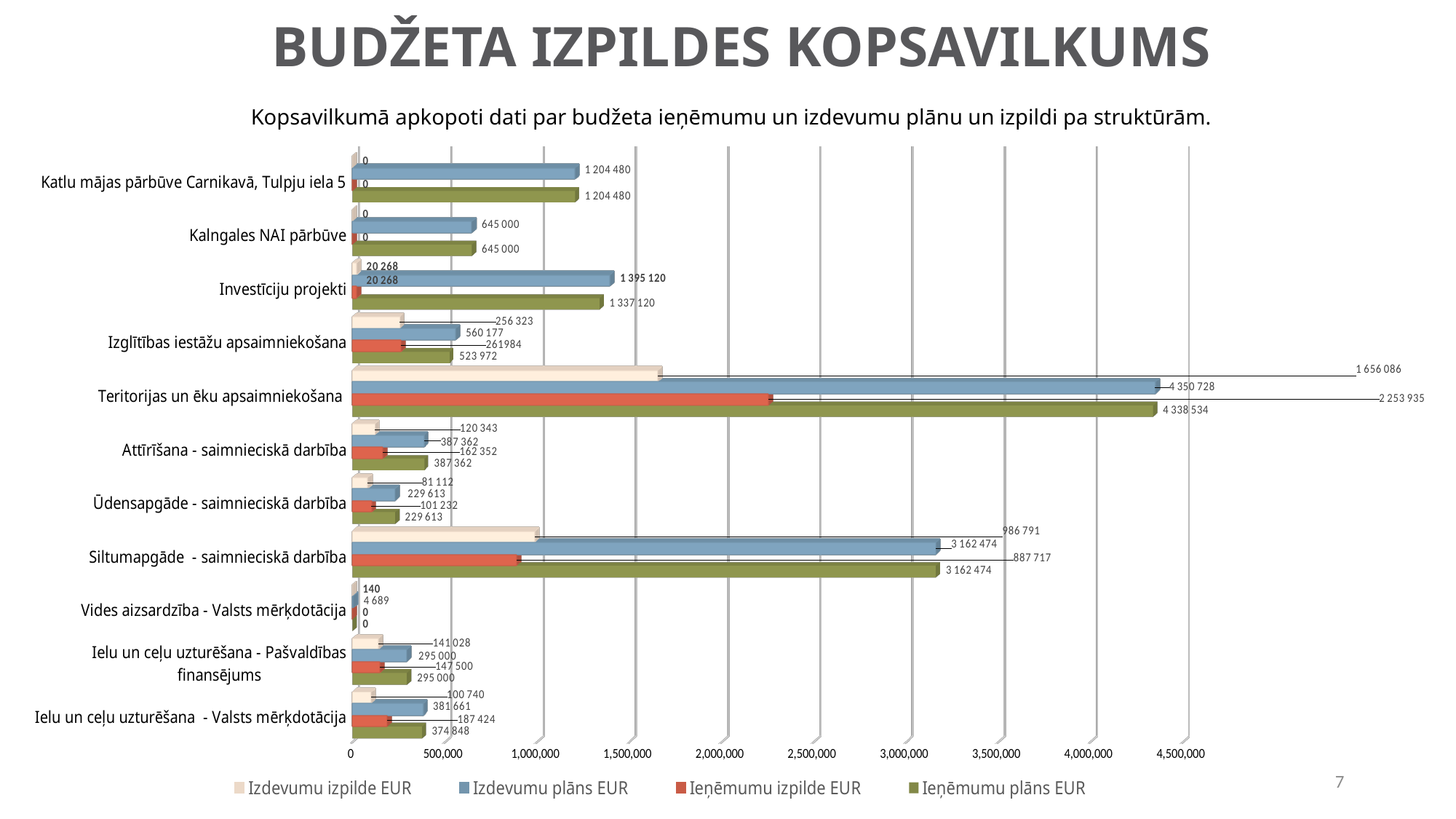
Is the Izdevumu izpilde EUR value for Teritorijas un ēku apsaimniekošana greater or less than 1,500,000? greater What is the Izdevumu plāns EUR value for Teritorijas un ēku apsaimniekošana? 4 350 728 For Ielu un ceļu uzturēšana - Valsts mērķdotācija, which is larger: Ieņēmumu izpilde EUR or Izdevumu izpilde EUR? Ieņēmumu izpilde EUR What is the Izdevumu izpilde EUR value for Izglītības iestāžu apsaimniekošana? 256 323 Which colour represents Ieņēmumu plāns EUR in the legend? green How many series does the legend list? 4 What is the difference between Izdevumu plāns EUR and Izdevumu izpilde EUR for Siltumapgāde - saimnieciskā darbība? 2 175 683 How many categories are shown on the chart? 11 What kind of chart is shown on the slide? bar chart What is the Ieņēmumu izpilde EUR value for Siltumapgāde - saimnieciskā darbība? 887 717 Which category has the lowest Izdevumu plāns EUR value? Vides aizsardzība - Valsts mērķdotācija Which category has the highest Ieņēmumu plāns EUR value? Teritorijas un ēku apsaimniekošana